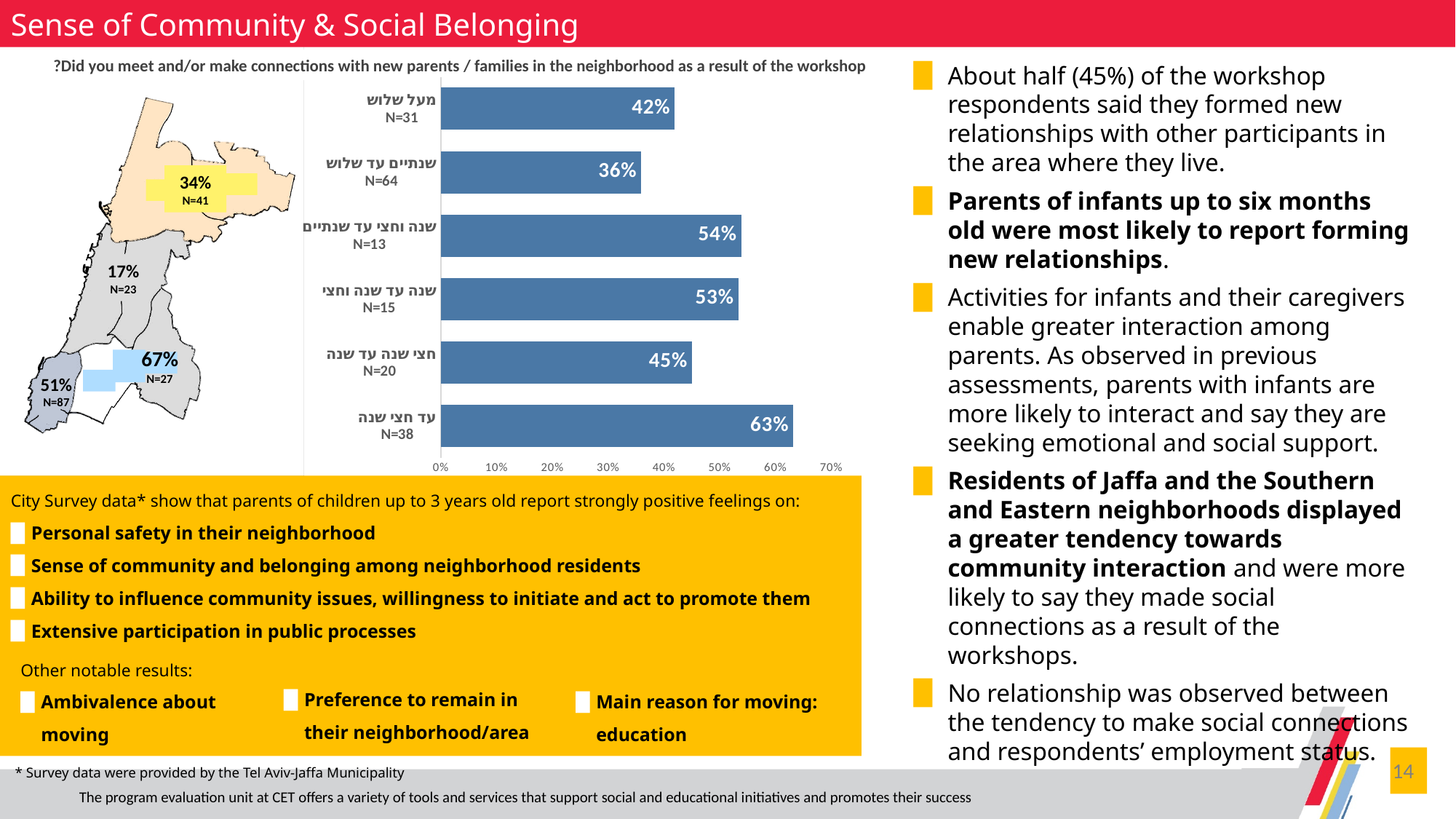
What is the difference in percentage points between the שנה וחצי עד שנתיים (N=13) bar and the שנה עד שנה וחצי (N=15) bar? 1 percentage point What percentage is shown for the category שנה עד שנה וחצי (N=15) in the bar chart? 53% What percentage is shown for the category עד חצי שנה (N=38) in the bar chart? 63% Which category in the bar chart has the lowest percentage? שנתיים עד שלוש (N=64) How many categories (bars) are shown in the bar chart? 6 What is the highest value labeled on the x axis of the bar chart? 70% What is the difference in percentage points between the עד חצי שנה (N=38) bar and the שנתיים עד שלוש (N=64) bar? 27 percentage points Is the value for חצי שנה עד שנה (N=20) greater or less than 40%? greater What percentage is shown for the category מעל שלוש (N=31) in the bar chart? 42% What type of chart is used to show the percentages by age group? Bar chart Which category in the bar chart has the highest percentage? עד חצי שנה (N=38) Which has a higher percentage in the bar chart: שנה וחצי עד שנתיים (N=13) or חצי שנה עד שנה (N=20)? שנה וחצי עד שנתיים (N=13)